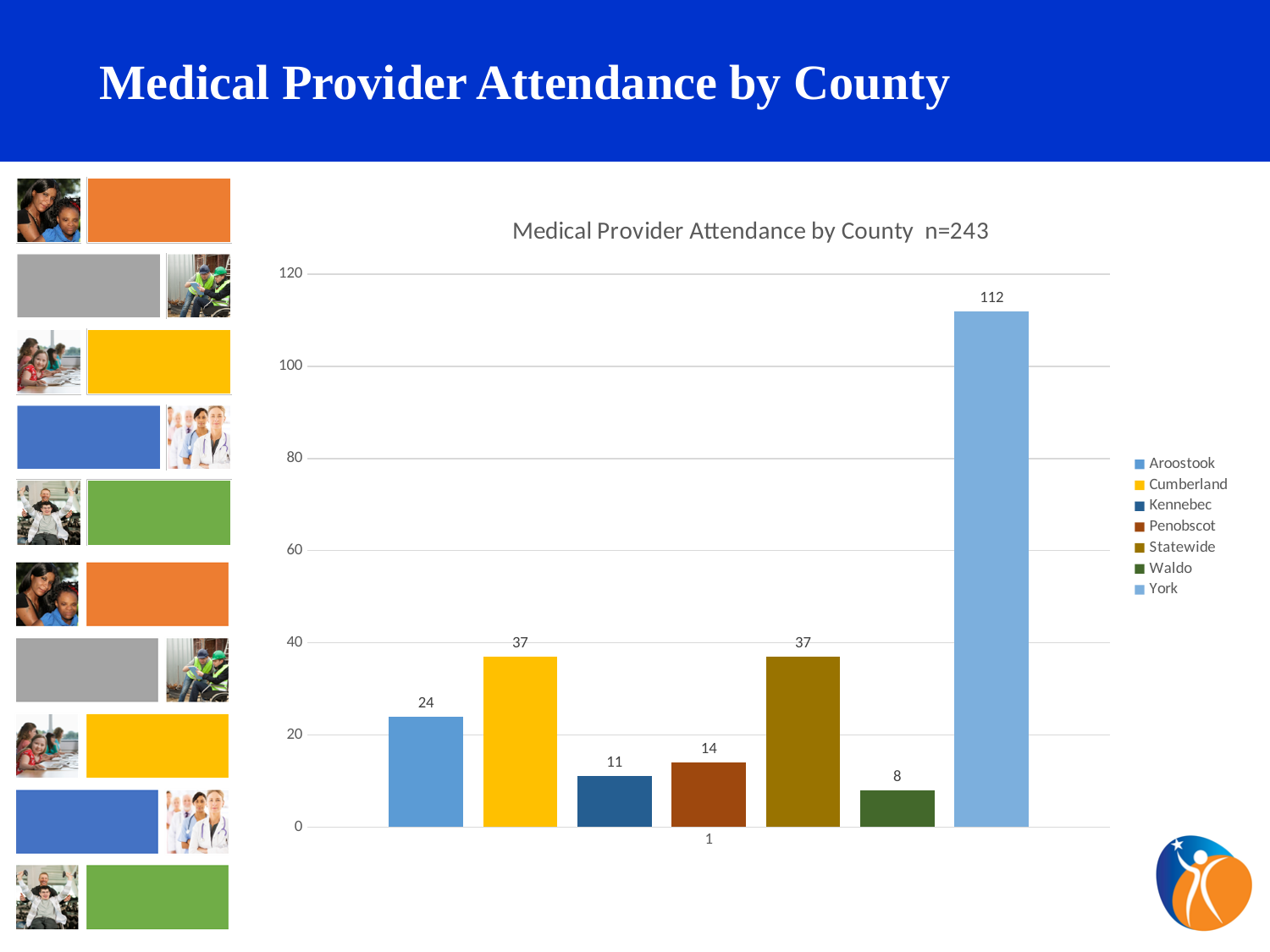
What is the value for Penobscot? 14 What is the value for Waldo? 8 What is the value for Aroostook? 24 What kind of chart is shown? Bar chart How many series does the legend list? 7 Which county has the highest attendance? York What is the title of the chart? Medical Provider Attendance by County n=243 What is the value for Kennebec? 11 What is the difference between the values for York and Cumberland? 75 What is the value for York? 112 Which county has the lowest attendance? Waldo Which is larger, the value for Aroostook or the value for Penobscot? Aroostook